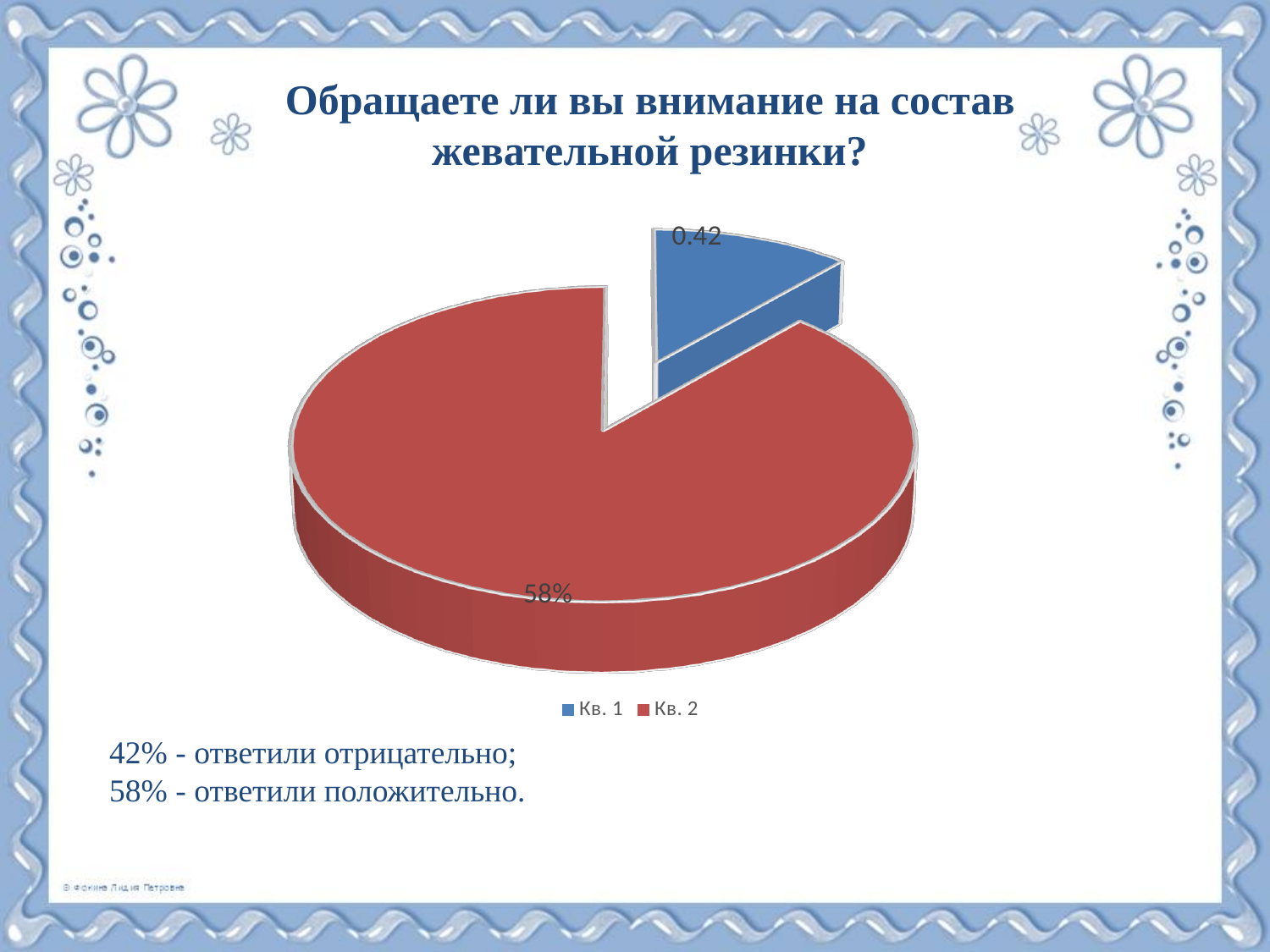
What kind of chart is shown on the slide? pie chart How many entries does the legend of the pie chart list? 2 How many slices does the pie chart have? 2 What is the data label shown on the Кв. 1 slice of the pie chart? 0.42 Which slice of the pie chart is the smallest? Кв. 1 Is the Кв. 2 slice of the pie chart more or less than half of the pie? more What is the data label shown on the Кв. 2 slice of the pie chart? 58% What colour is the Кв. 2 slice in the pie chart? red Which slice is larger in the pie chart, Кв. 1 or Кв. 2? Кв. 2 What colour is the Кв. 1 slice in the pie chart? blue Which slice of the pie chart is the largest? Кв. 2